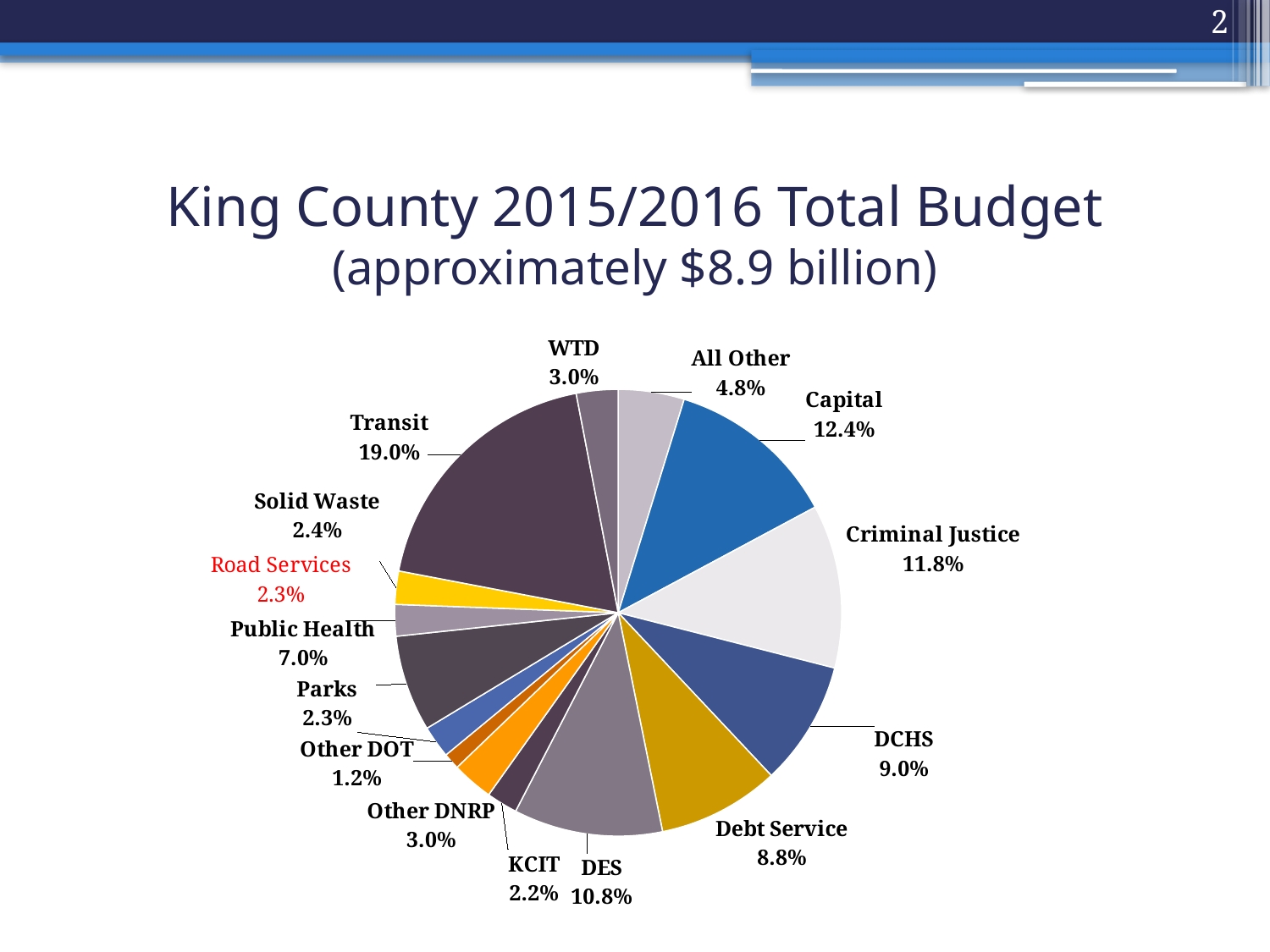
What percentage is shown for DES? 10.8% What percentage is shown for Criminal Justice? 11.8% What share of the budget does Transit account for? 19.0% What percentage is shown for Road Services? 2.3% How many categories are shown in the pie chart? 15 Which category label is shown in red text? Road Services Which category has the smallest share of the budget? Other DOT What is the difference in percentage points between Capital and DCHS? 3.4% What is the title of the chart on the slide? King County 2015/2016 Total Budget (approximately $8.9 billion) What kind of chart is shown on the slide? Pie chart Which is larger, the share for Public Health or the share for Debt Service? Debt Service Which category has the largest share of the budget? Transit